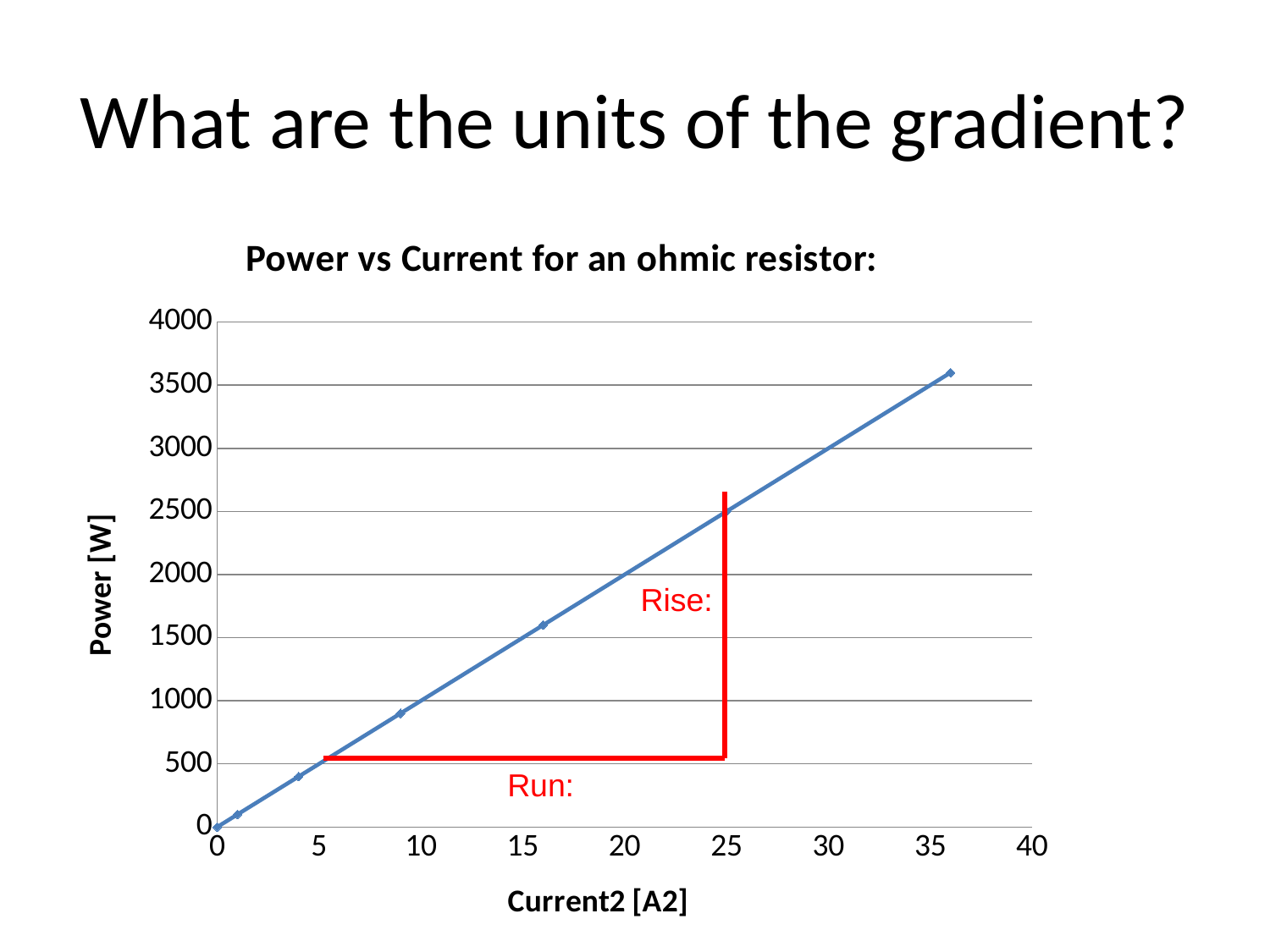
At which x-axis value is the plotted power highest? 36 What is the power value at an x-axis value of 0? 0 Which has the larger power value: the point at x = 16 or the point at x = 25? the point at x = 25 Is the power value at an x-axis value of 9 greater or less than 1000? less What is the power value at an x-axis value of 25? 2500 What kind of chart is shown on the slide? line chart Is the power value at an x-axis value of 16 greater or less than 1500? greater How many data points are plotted on the line? 7 What is the title of the chart? Power vs Current for an ohmic resistor: What is the label of the vertical axis? Power [W] Is the power value at an x-axis value of 36 greater or less than 3500? greater Does the power rise or fall as the value on the x axis increases? rise